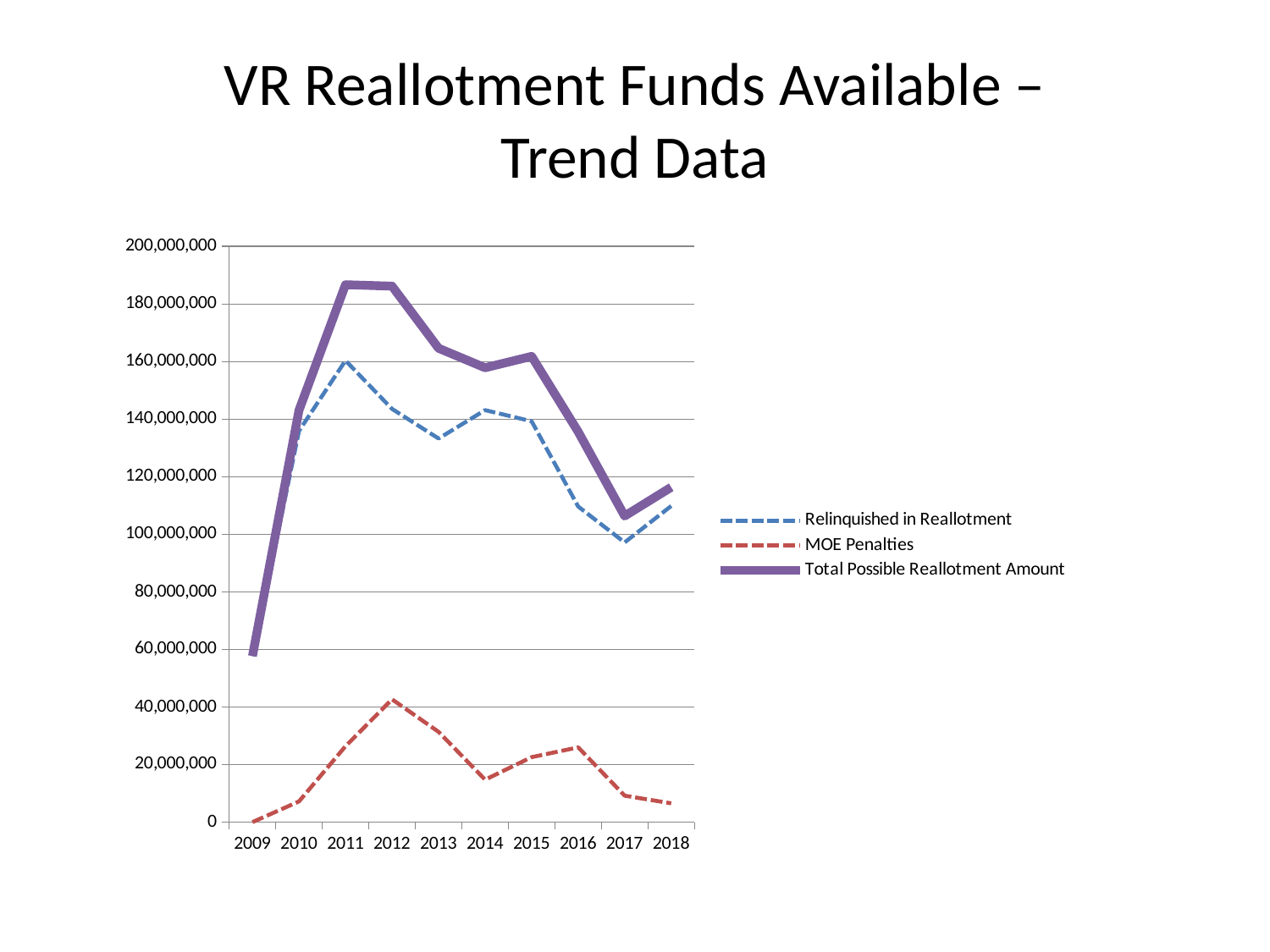
Is the MOE Penalties value for 2012 greater or less than 30,000,000? greater Does the Total Possible Reallotment Amount rise or fall from 2015 to 2017? fall Which is larger, the Total Possible Reallotment Amount in 2013 or in 2016? 2013 Is the Total Possible Reallotment Amount for 2011 greater or less than 180,000,000? greater How many series does the legend list? 3 Is the Total Possible Reallotment Amount for 2009 greater or less than 80,000,000? less What kind of chart is shown on the slide? line chart In which year is the MOE Penalties value highest? 2012 In which year is the Total Possible Reallotment Amount lowest? 2009 What is the title of the chart on the slide? VR Reallotment Funds Available – Trend Data How many years are shown on the x axis? 10